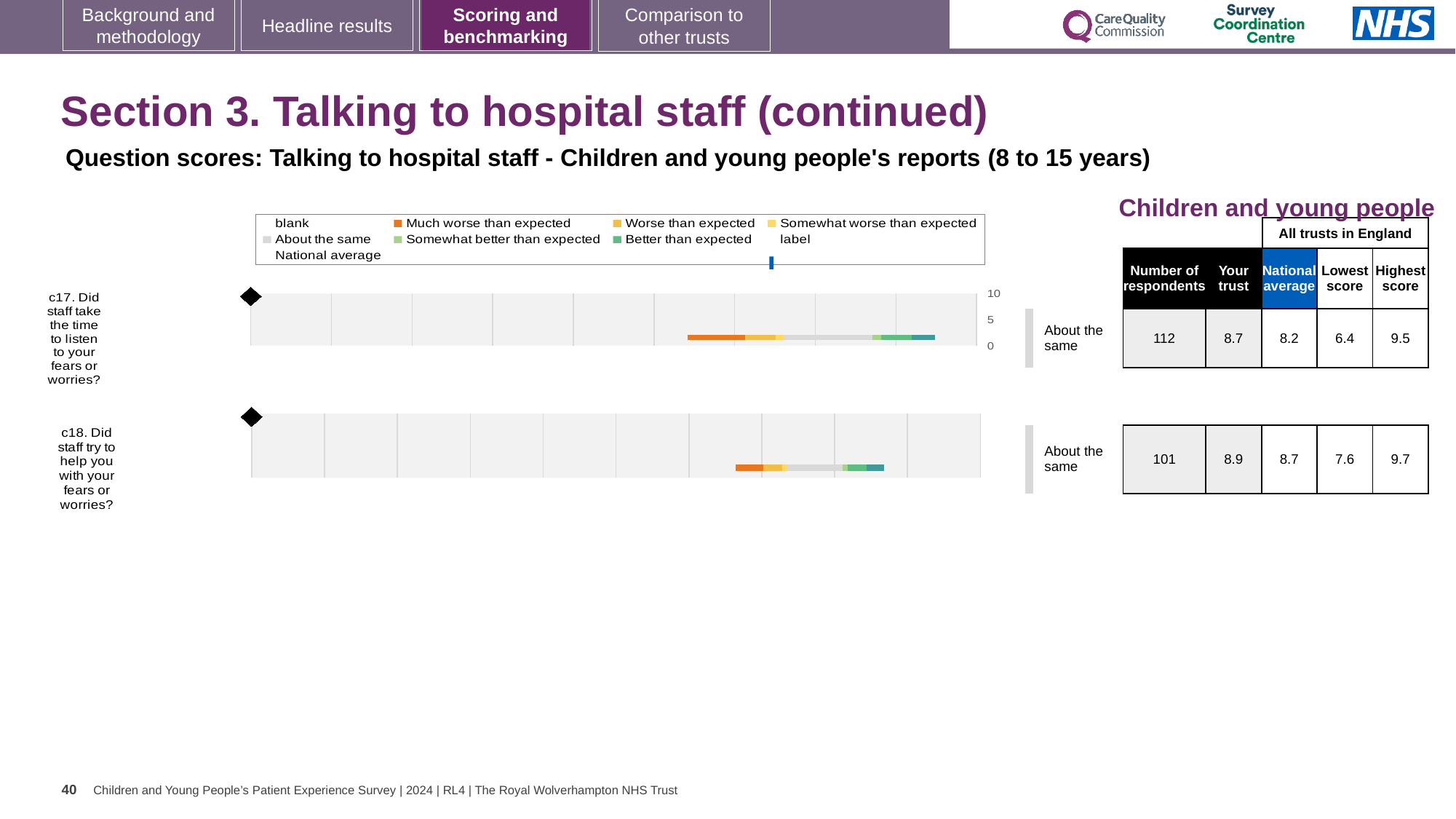
How many respondents answered c18? 101 Which question has the higher 'Your trust' score, c17 or c18? c18 What is the 'Your trust' score for c18 (Did staff try to help you with your fears or worries?)? 8.9 What is the highest score among all trusts in England for c18? 9.7 What benchmark category is the trust's score for c17 placed in? About the same What kind of chart is used to show the benchmarking for each question? Bar chart What is the difference between the highest and lowest scores for c17? 3.1 How many questions are plotted on this slide? 2 What is the 'Your trust' score for c17 (Did staff take the time to listen to your fears or worries?)? 8.7 What is the national average score for c17? 8.2 By how much does the trust's score for c18 exceed the national average? 0.2 What is the lowest score among all trusts in England for c17? 6.4